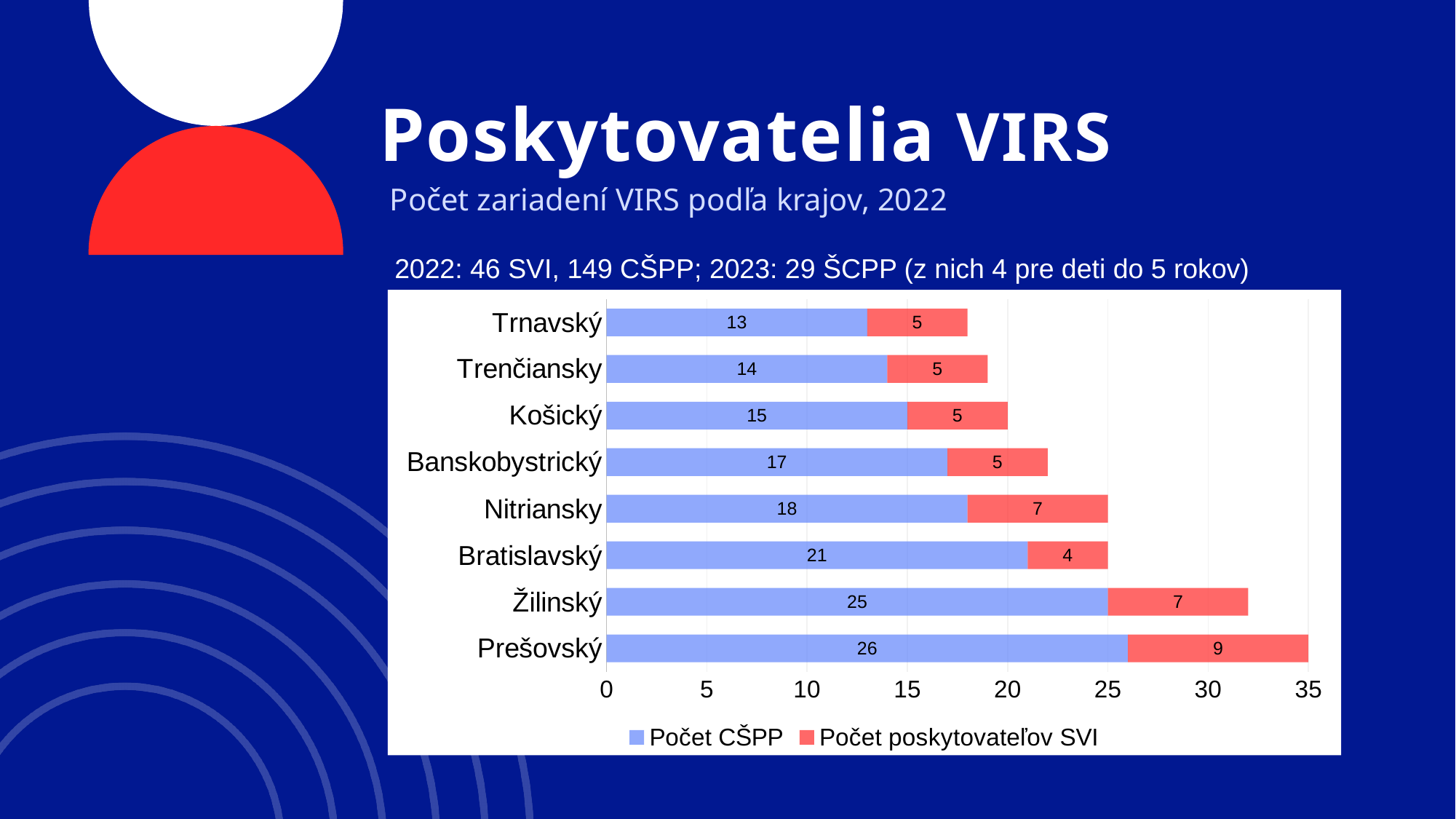
How many series does the legend list? 2 How many regions are shown in the chart? 8 What kind of chart is shown on the slide? Bar chart Which is larger: Počet poskytovateľov SVI for Prešovský or for Bratislavský? Prešovský What is the value of Počet poskytovateľov SVI for Nitriansky? 7 What is the value of Počet CŠPP for Prešovský? 26 What is the total of the stacked bar for Košický? 20 What is the total of the stacked bar for Prešovský? 35 Which region has the highest value of Počet CŠPP? Prešovský What is the value of Počet CŠPP for Banskobystrický? 17 What is the difference between Počet CŠPP for Žilinský and Bratislavský? 4 Which region has the lowest value of Počet CŠPP? Trnavský